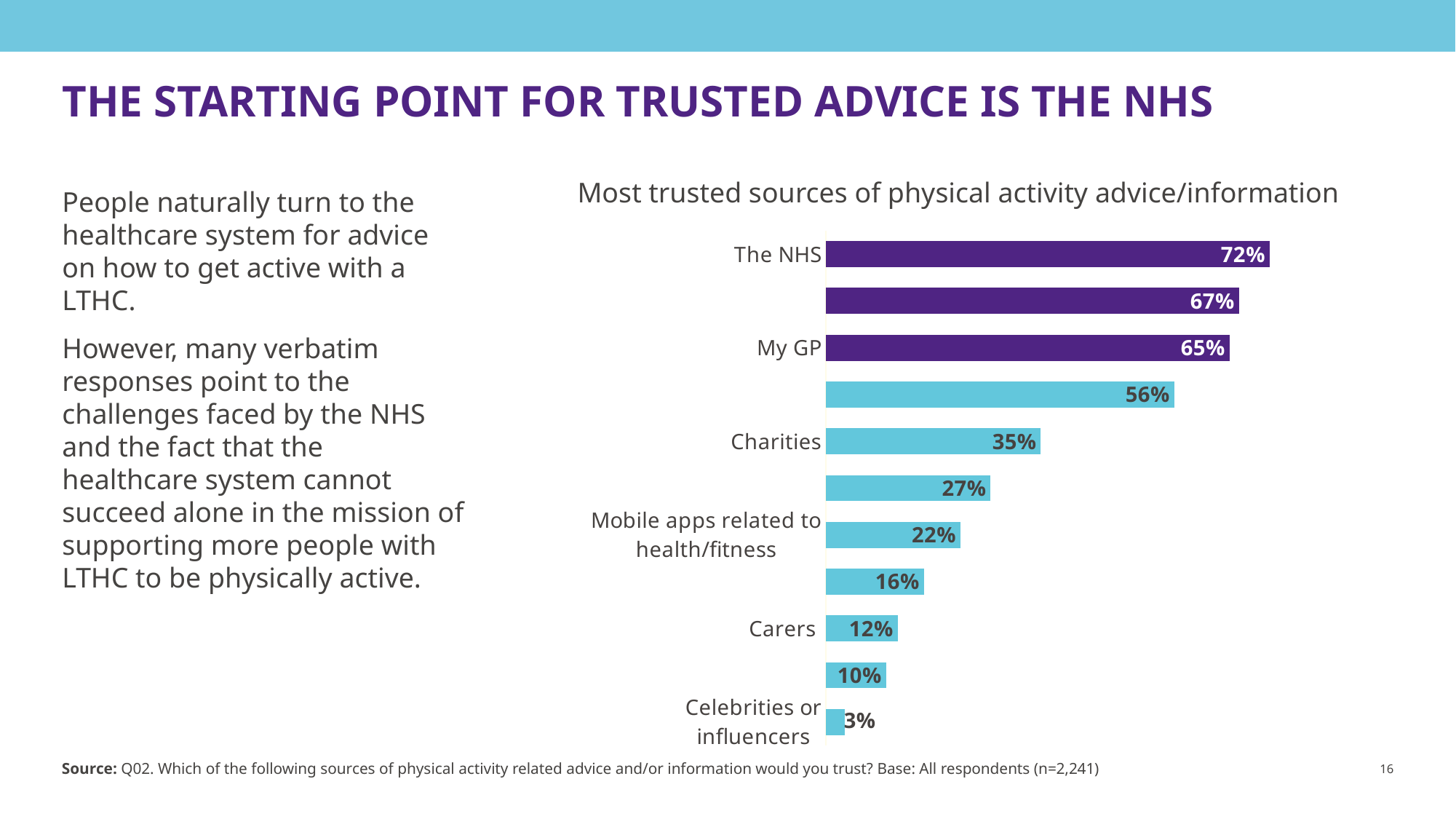
Which is trusted by more respondents, Charities or Carers? Charities What is the value shown for Mobile apps related to health/fitness? 22% What is the value shown for Charities? 35% Which source has the lowest trust percentage? Celebrities or influencers What is the value shown for Celebrities or influencers? 3% What type of chart is shown on the slide? Bar chart What percentage of respondents trust The NHS as a source of physical activity advice? 72% Which source has the highest trust percentage? The NHS How many bars are plotted in the chart? 11 What is the value shown for My GP? 65% What is the difference in percentage points between The NHS and My GP? 7 What is the value shown for Carers? 12%